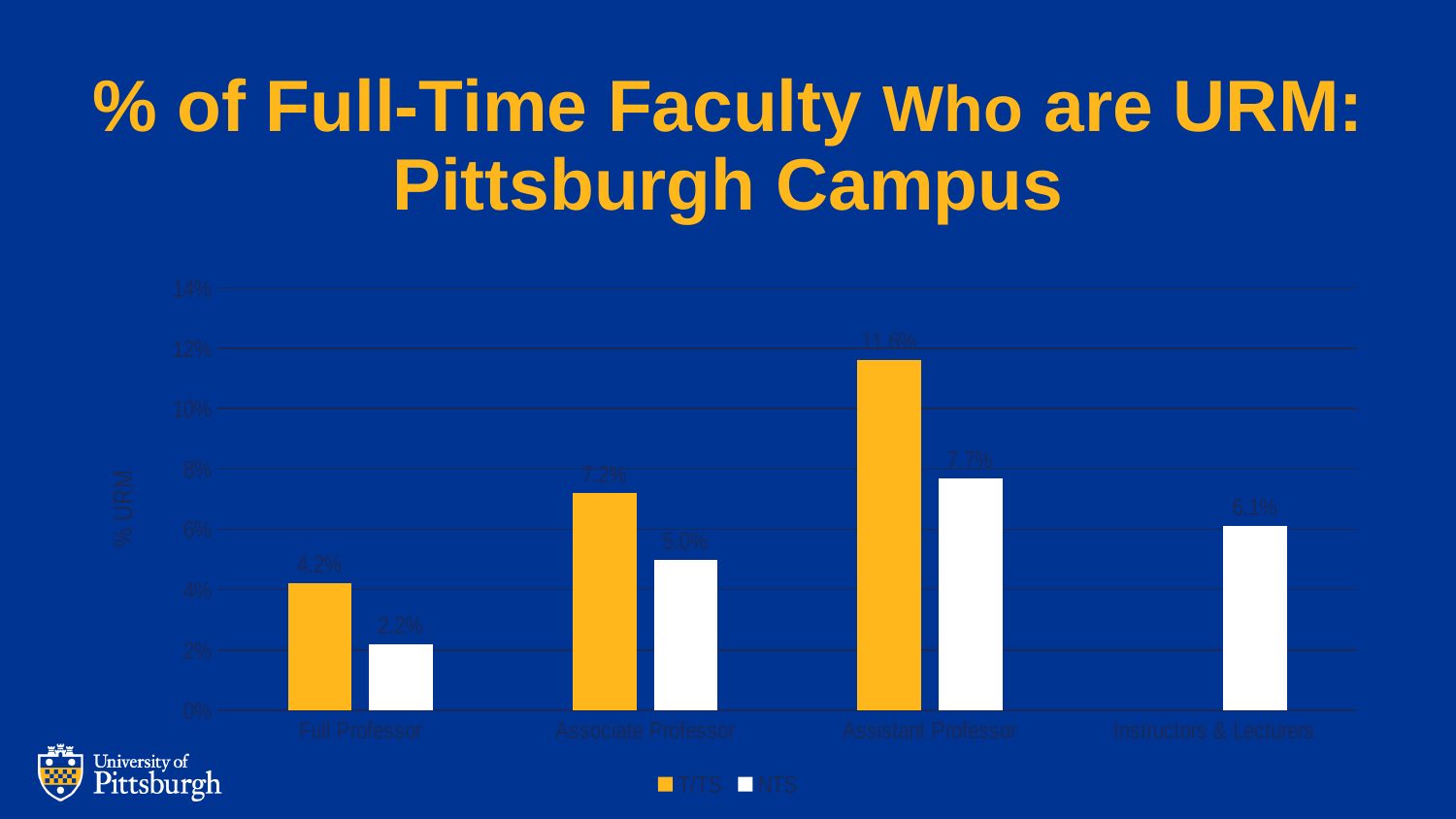
What is the NTS value for Instructors & Lecturers? 6.1% How many series does the legend list? 2 What is the difference between the T/TS and NTS values for Assistant Professor? 3.9% How many categories are shown on the x axis? 4 Which category has the lowest NTS value? Full Professor What is the T/TS value for Associate Professor? 7.2% Is the NTS value for Assistant Professor greater or less than 6%? greater What is the NTS value for Full Professor? 2.2% What kind of chart is shown on the slide? Bar chart Which is larger for Associate Professor, the T/TS value or the NTS value? T/TS What is the T/TS value for Assistant Professor? 11.6% Which category has the highest T/TS value? Assistant Professor